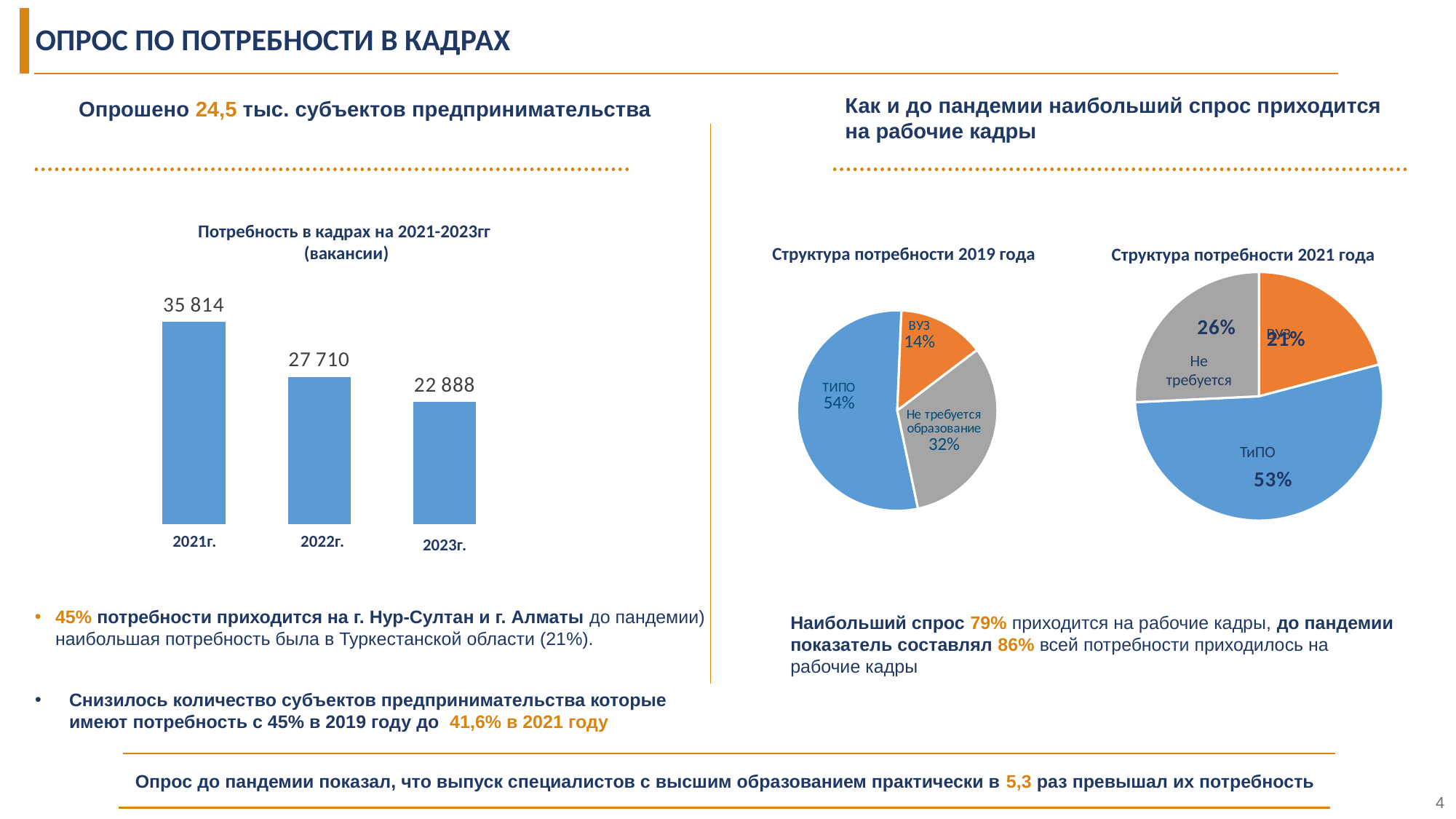
What kind of chart is 'Потребность в кадрах на 2021-2023гг (вакансии)'? bar chart In the pie chart 'Структура потребности 2021 года', what share does ВУЗ have? 21% In the chart 'Потребность в кадрах на 2021-2023гг (вакансии)', what is the value for 2023г.? 22 888 How many bars are in the chart 'Потребность в кадрах на 2021-2023гг (вакансии)'? 3 In the pie chart 'Структура потребности 2021 года', which category has the smallest share? ВУЗ In the chart 'Потребность в кадрах на 2021-2023гг (вакансии)', which year has the highest value? 2021г. In the chart 'Потребность в кадрах на 2021-2023гг (вакансии)', what is the difference between the values for 2021г. and 2022г.? 8 104 In the chart 'Потребность в кадрах на 2021-2023гг (вакансии)', do the values rise or fall from 2021г. to 2023г.? fall Which is larger: the ВУЗ share in 'Структура потребности 2019 года' or the ВУЗ share in 'Структура потребности 2021 года'? 2021 года (21%) In the chart 'Потребность в кадрах на 2021-2023гг (вакансии)', what is the value for 2021г.? 35 814 In the pie chart 'Структура потребности 2019 года', what share does 'Не требуется образование' have? 32% In the pie chart 'Структура потребности 2019 года', what share does ТиПО have? 54%